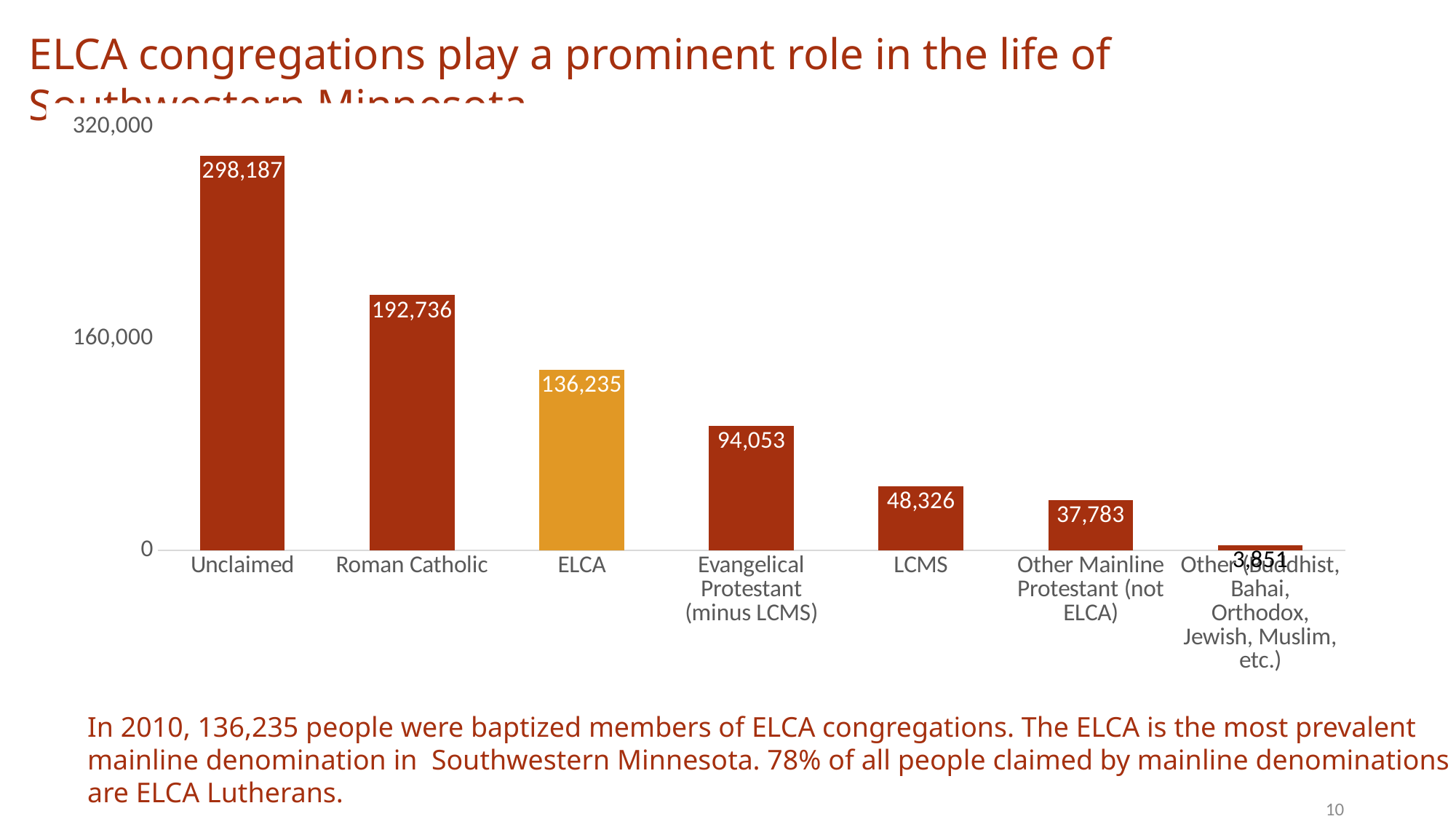
What kind of chart is shown on the slide? bar chart How many categories are shown in the chart? 7 Which category has the highest value? Unclaimed What is the value for LCMS? 48,326 Is the value for Roman Catholic greater or less than 160,000? greater What is the value for Roman Catholic? 192,736 What is the value for ELCA? 136,235 What is the difference between the ELCA value and the Evangelical Protestant (minus LCMS) value? 42,182 Which category has the lowest value? Other (Buddhist, Bahai, Orthodox, Jewish, Muslim, etc.) Which is larger, the value for LCMS or the value for Other Mainline Protestant (not ELCA)? LCMS What is the difference between the Unclaimed value and the Roman Catholic value? 105,451 What is the value for Other Mainline Protestant (not ELCA)? 37,783